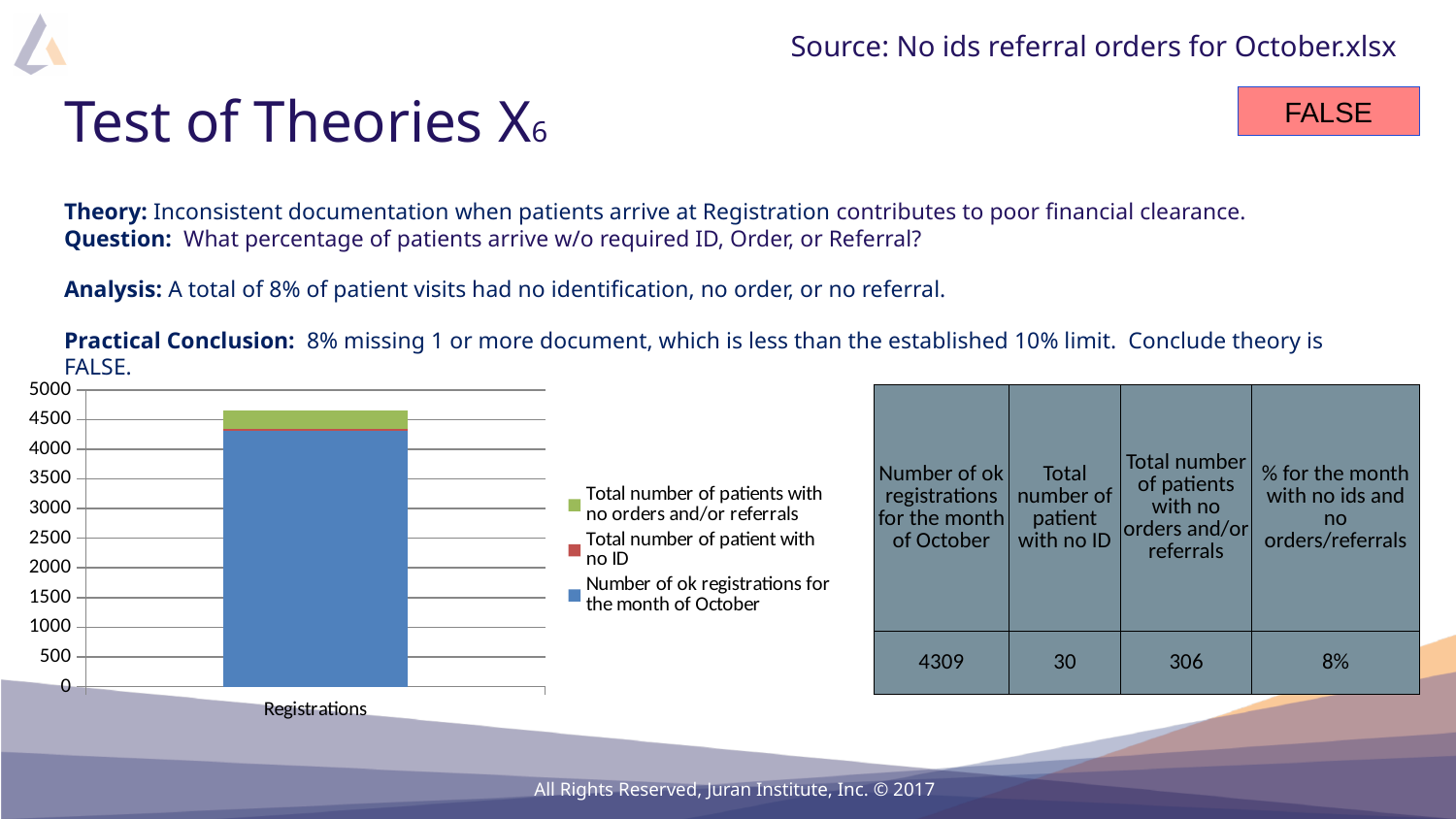
How many series does the chart legend list? 3 Using the values in the table, what is the total of the stacked Registrations bar? 4645 Is the value for 'Number of ok registrations for the month of October' greater or less than 4000? greater Is the total height of the stacked Registrations bar greater or less than 4500? greater According to the table on the slide, what is the total number of patients with no orders and/or referrals? 306 What colour represents 'Number of ok registrations for the month of October' in the chart? blue According to the table on the slide, what is the number of ok registrations for the month of October? 4309 How many categories are plotted on the x axis of the chart? 1 What kind of chart is shown on the slide? bar chart Which series makes up the smallest part of the Registrations bar? Total number of patient with no ID Which series makes up the largest part of the Registrations bar? Number of ok registrations for the month of October What is the label of the category on the x axis of the chart? Registrations